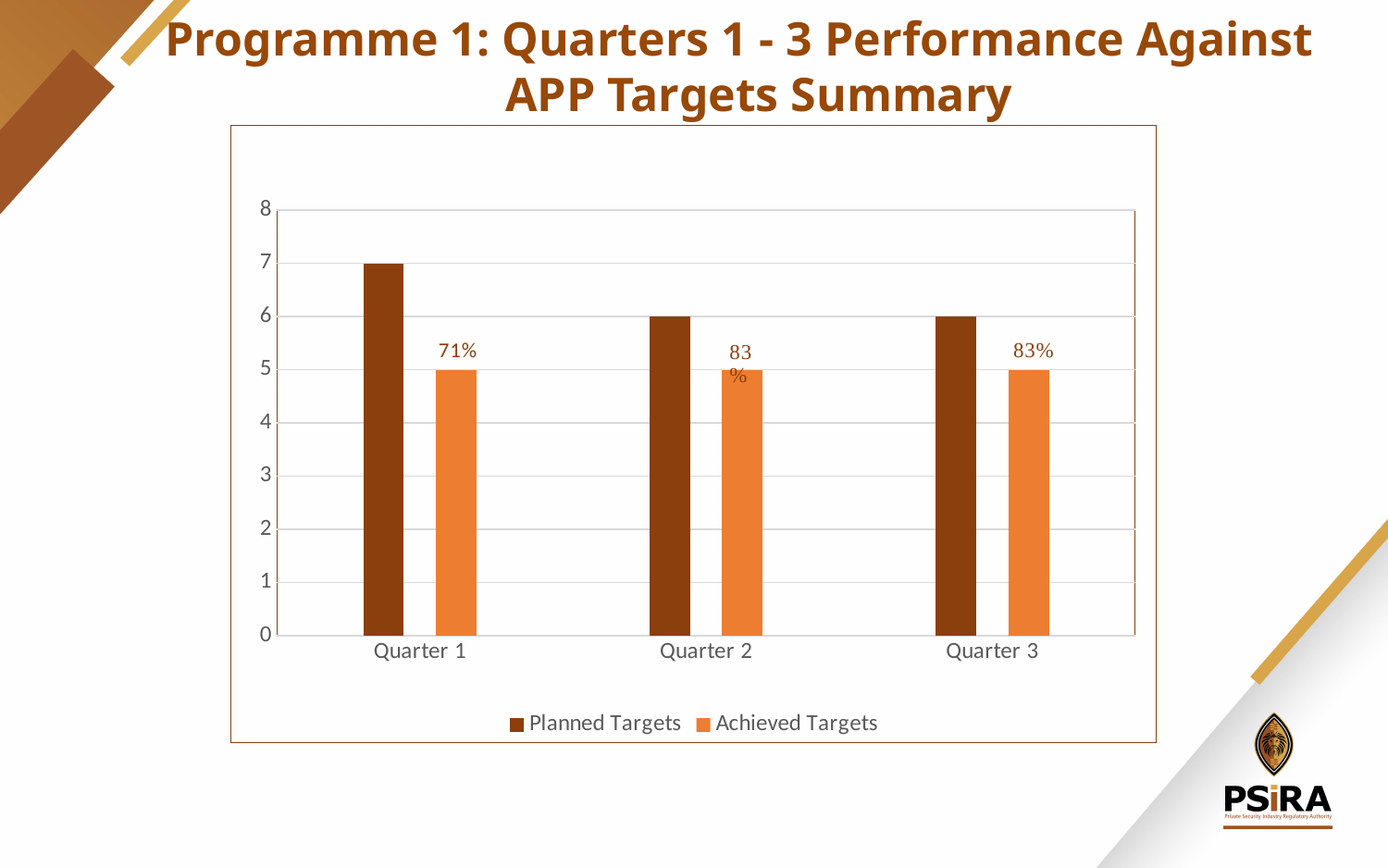
What percentage label is shown on the Achieved Targets bar for Quarter 1? 71% What is the Planned Targets value for Quarter 1? 7 What is the Planned Targets value for Quarter 2? 6 How many series does the legend list? 2 What kind of chart is shown on the slide? bar chart What is the title of the slide? Programme 1: Quarters 1 - 3 Performance Against APP Targets Summary Which is larger in Quarter 2, Planned Targets or Achieved Targets? Planned Targets What percentage label is shown on the Achieved Targets bar for Quarter 3? 83% Which quarter has the highest Planned Targets value? Quarter 1 What is the Achieved Targets value for Quarter 3? 5 How many quarters are shown on the x axis? 3 What is the difference between Planned Targets and Achieved Targets in Quarter 1? 2